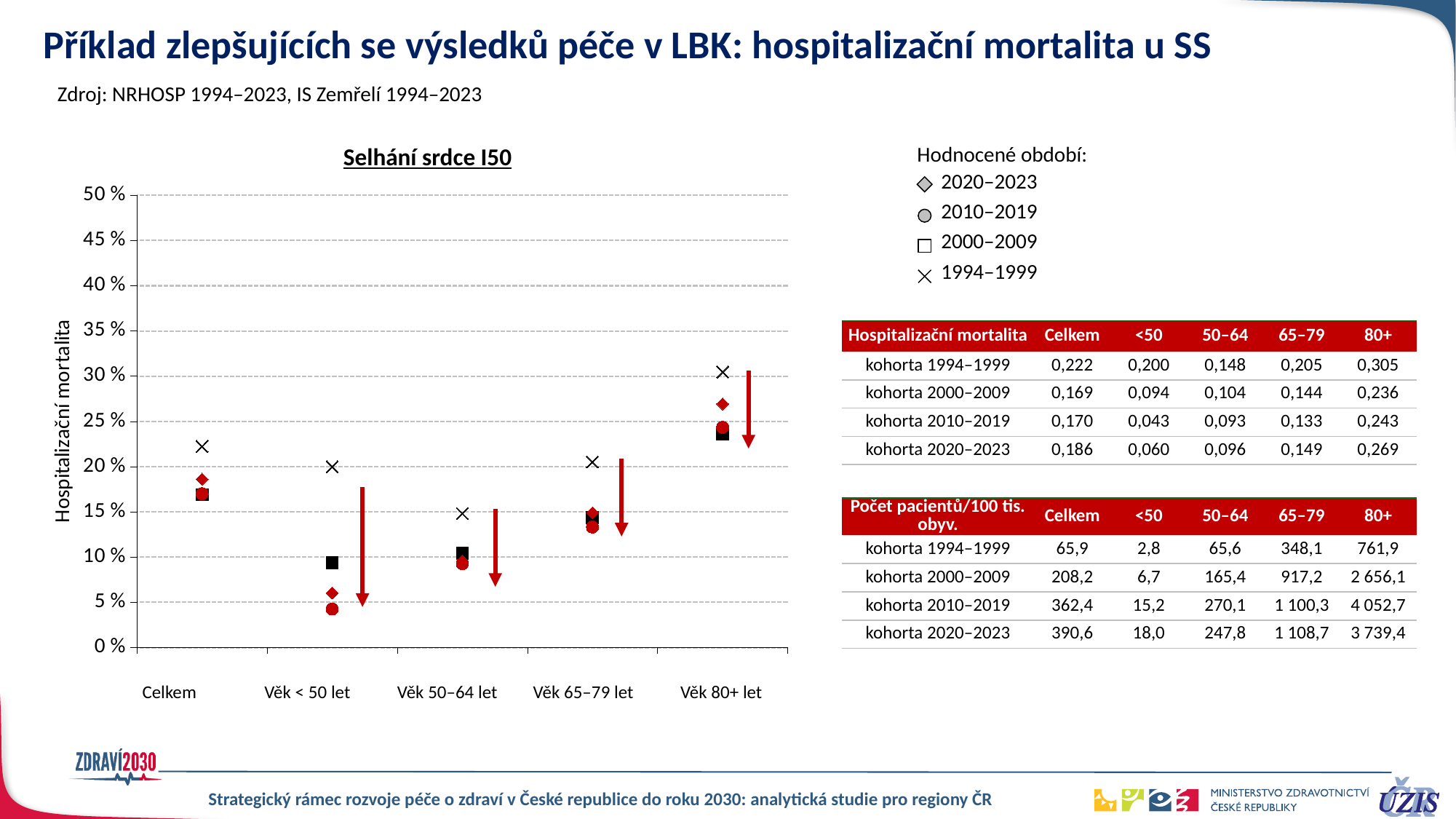
What is the title of the chart on the slide? Selhání srdce I50 How many categories are shown on the x axis of the chart? 5 For Celkem, which period has the larger hospitalization mortality: 1994–1999 or 2020–2023? 1994–1999 Is the 1994–1999 value for Věk 80+ let greater or less than 25 %? greater According to the 'Hospitalizační mortalita' table, what is the value for kohorta 1994–1999 in the 80+ column? 0,305 Is the 2010–2019 value for Věk < 50 let greater or less than 5 %? less Which category has the highest 1994–1999 value in the chart? Věk 80+ let How many periods (series) does the legend 'Hodnocené období' list? 4 Is the 1994–1999 value for Celkem greater or less than 20 %? greater What kind of chart is shown on the slide? scatter chart Which category has the lowest 2010–2019 value in the chart? Věk < 50 let What is the label of the vertical axis of the chart? Hospitalizační mortalita